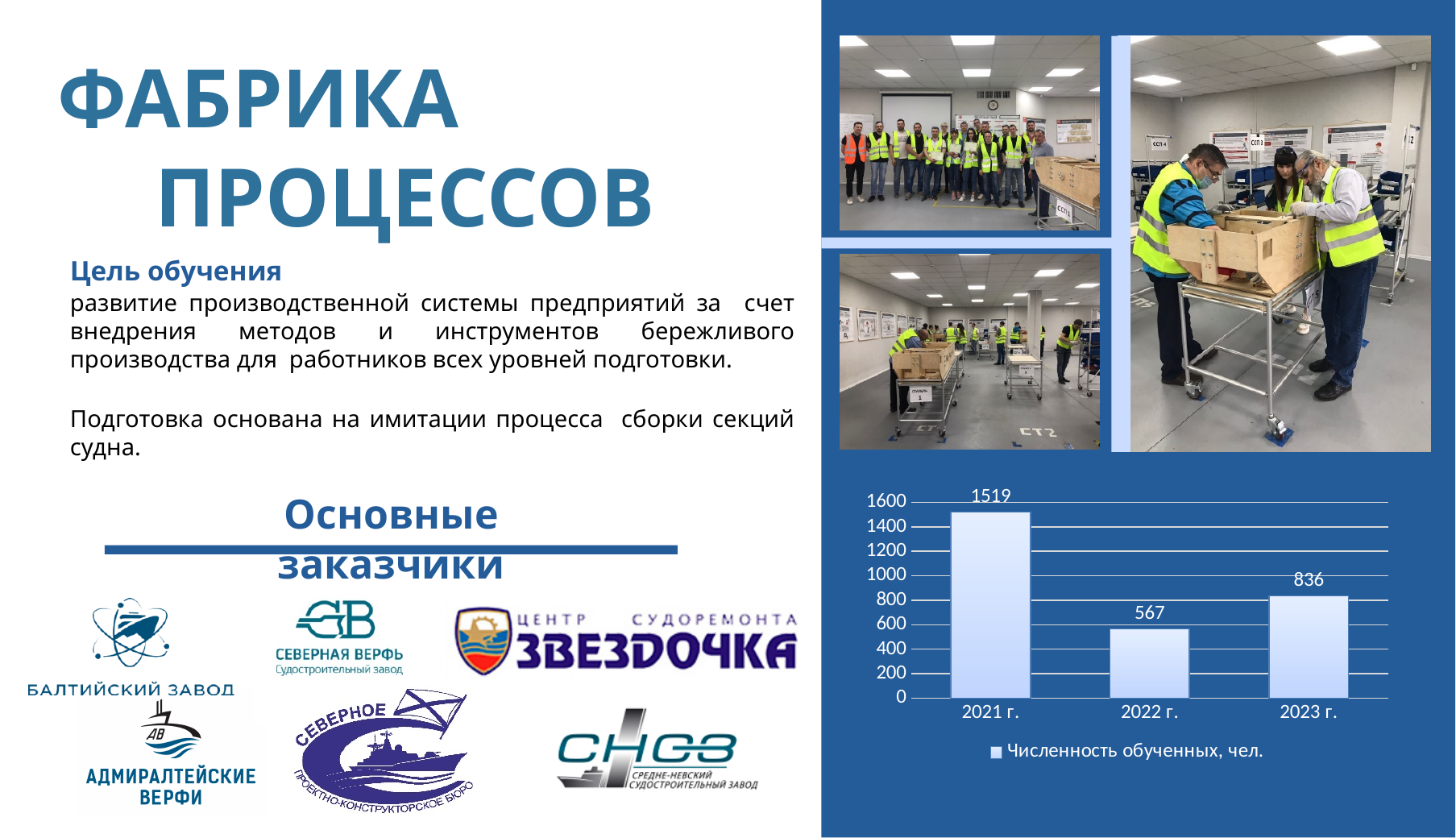
What is the value for 2021 г. in the chart? 1519 How many categories are shown on the x axis of the chart? 3 Is the value for 2022 г. greater or less than 600? less What is the value for 2023 г. in the chart? 836 What is the difference between the values for 2021 г. and 2022 г.? 952 Which year has the highest value in the chart? 2021 г. What is the value for 2022 г. in the chart? 567 What series name does the chart legend show? Численность обученных, чел. Which is larger, the value for 2023 г. or the value for 2022 г.? 2023 г. Which year has the lowest value in the chart? 2022 г. What is the difference between the values for 2023 г. and 2022 г.? 269 What kind of chart is shown on the slide? bar chart